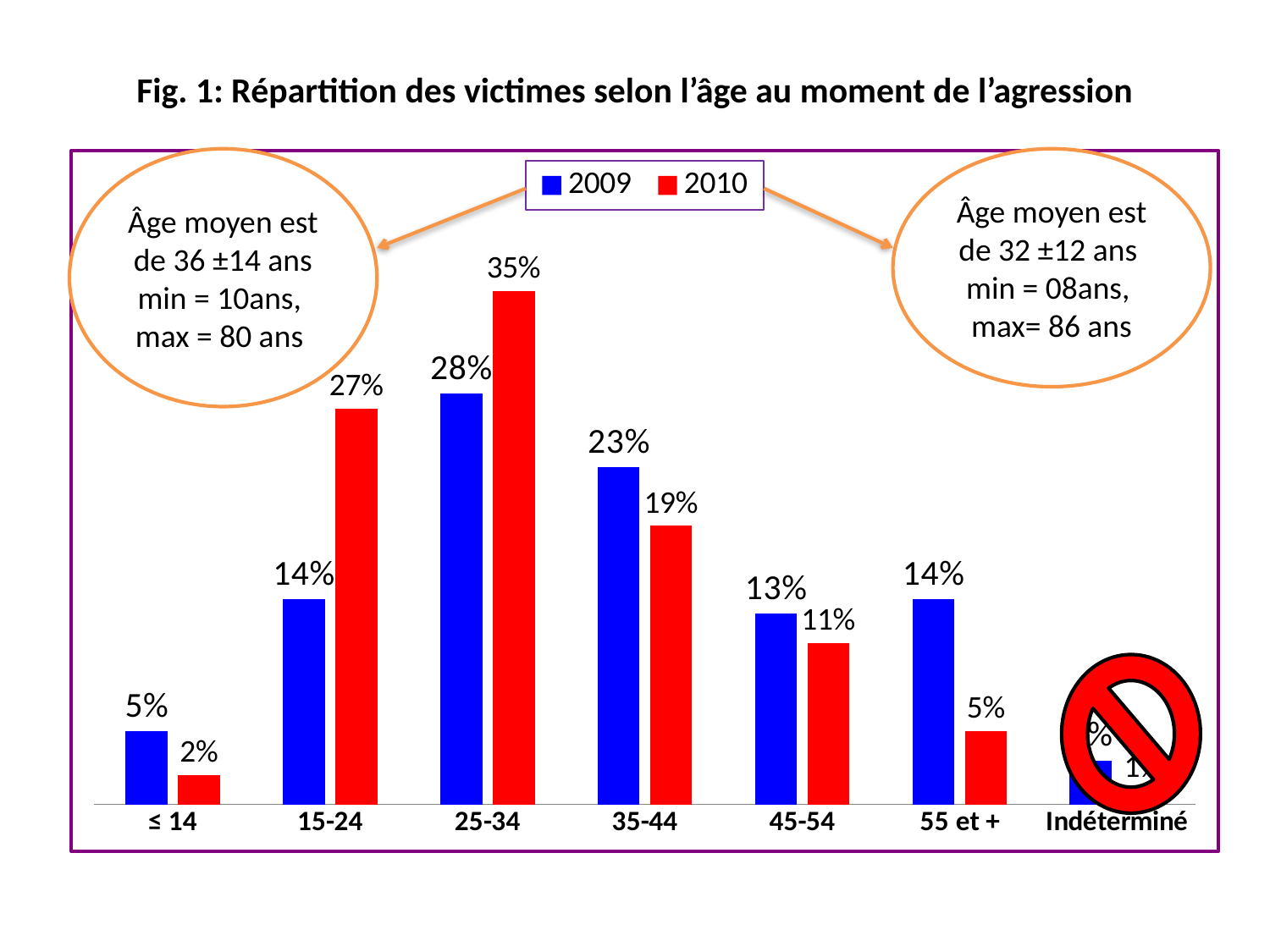
What is the value for 2010 in the 15-24 age group? 27% What is the value for 2009 in the ≤ 14 age group? 5% How many series does the legend list? 2 What is the difference between the 2010 and 2009 values in the 15-24 age group? 13% How many age categories are shown on the x axis? 7 Which is larger in the 55 et + age group, the 2009 value or the 2010 value? 2009 What is the value for 2010 in the 25-34 age group? 35% Which colour represents the 2010 series in the legend? Red What is the value for 2009 in the 35-44 age group? 23% What kind of chart is shown on the slide? Bar chart Which age group has the highest value for the 2009 series? 25-34